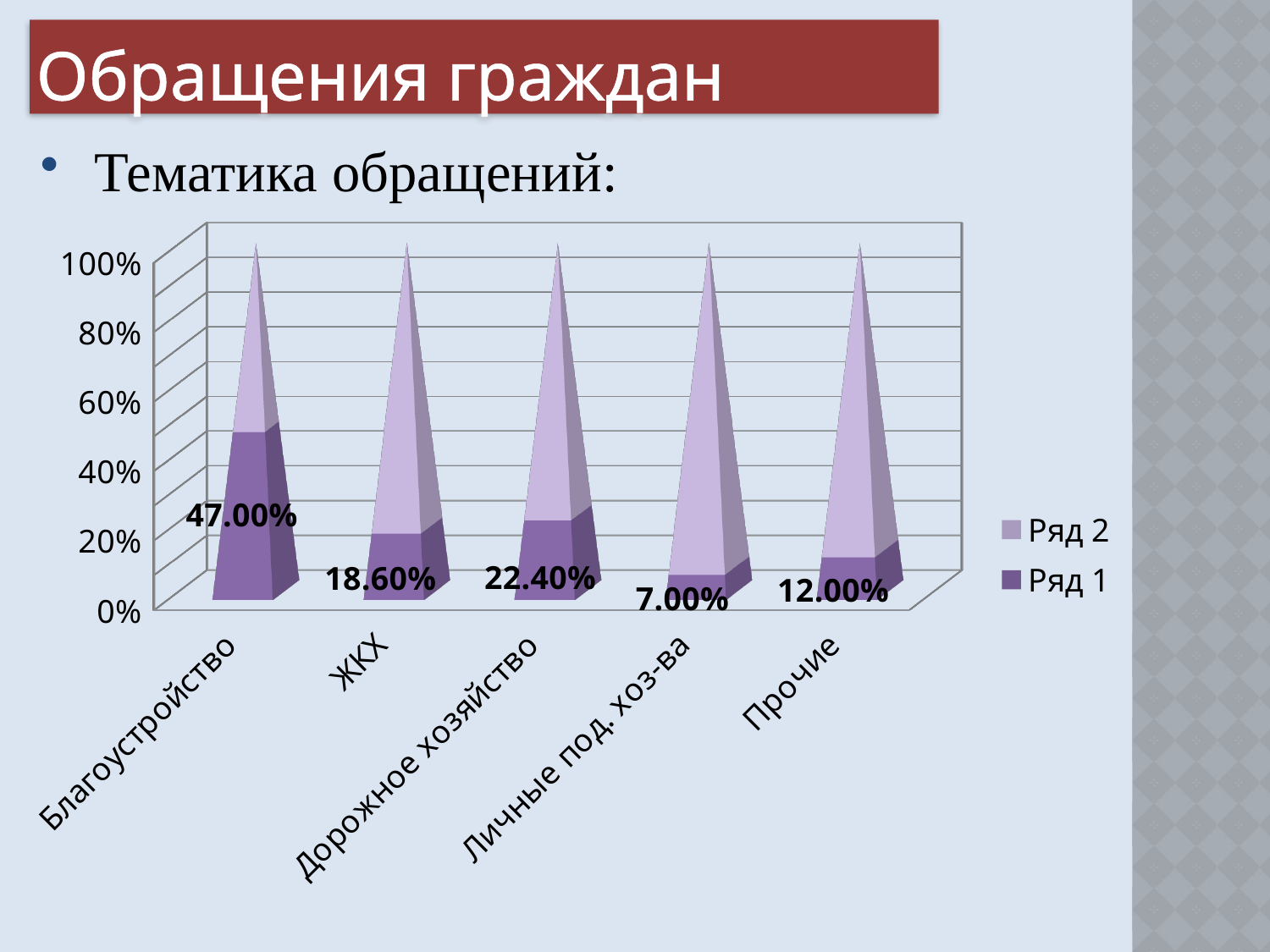
Which has a larger Ряд 1 value, Дорожное хозяйство or Прочие? Дорожное хозяйство What is the value of Ряд 1 for ЖКХ? 18.60% How many series does the legend list? 2 Which category has the highest Ряд 1 value? Благоустройство Which category has the lowest Ряд 1 value? Личные под. хоз-ва How many categories are shown on the x axis? 5 What is the value of Ряд 1 for Дорожное хозяйство? 22.40% What kind of chart is shown on the slide? Bar chart What is the difference between the Ряд 1 values for Благоустройство and ЖКХ? 28.40% What is the value of Ряд 1 for Личные под. хоз-ва? 7.00% What is the value of Ряд 1 for Прочие? 12.00% What is the value of Ряд 1 for Благоустройство? 47.00%